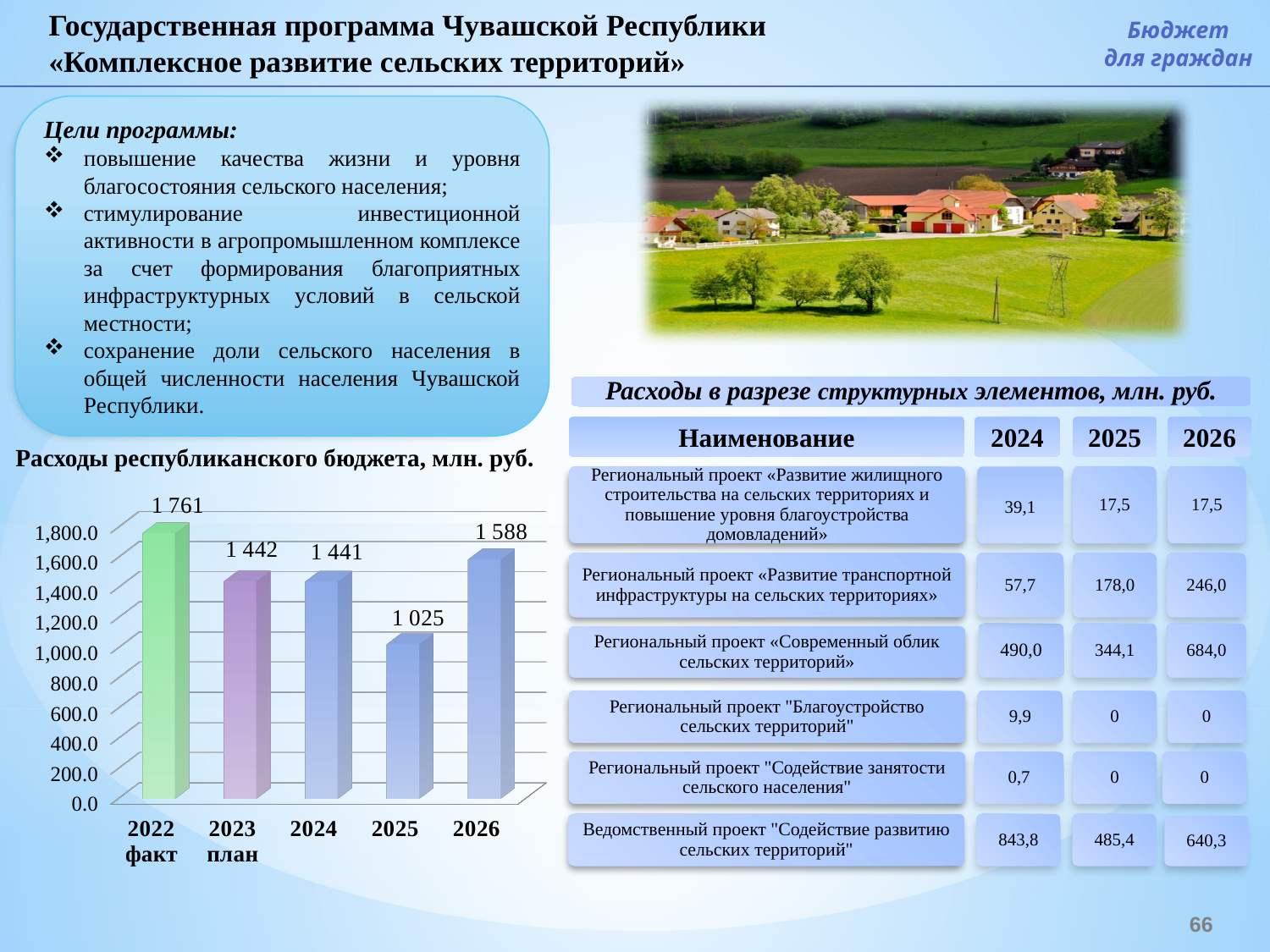
What is the value for 2026 in the chart 'Расходы республиканского бюджета, млн. руб.'? 1 588 In the chart 'Расходы республиканского бюджета, млн. руб.', what is the difference between the values for 2026 and 2025? 563 In the chart 'Расходы республиканского бюджета, млн. руб.', do the values rise or fall from 2022 to 2025? fall What is the value for 2025 in the chart 'Расходы республиканского бюджета, млн. руб.'? 1 025 What is the value for 2023 (план) in the chart 'Расходы республиканского бюджета, млн. руб.'? 1 442 How many bars are shown in the chart 'Расходы республиканского бюджета, млн. руб.'? 5 Which year has the highest value in the chart 'Расходы республиканского бюджета, млн. руб.'? 2022 Which year has the lowest value in the chart 'Расходы республиканского бюджета, млн. руб.'? 2025 In the chart 'Расходы республиканского бюджета, млн. руб.', which is larger: the value for 2024 or the value for 2026? 2026 In the chart 'Расходы республиканского бюджета, млн. руб.', what is the difference between the values for 2022 and 2025? 736 What is the value for 2022 (факт) in the chart 'Расходы республиканского бюджета, млн. руб.'? 1 761 What kind of chart is 'Расходы республиканского бюджета, млн. руб.'? bar chart